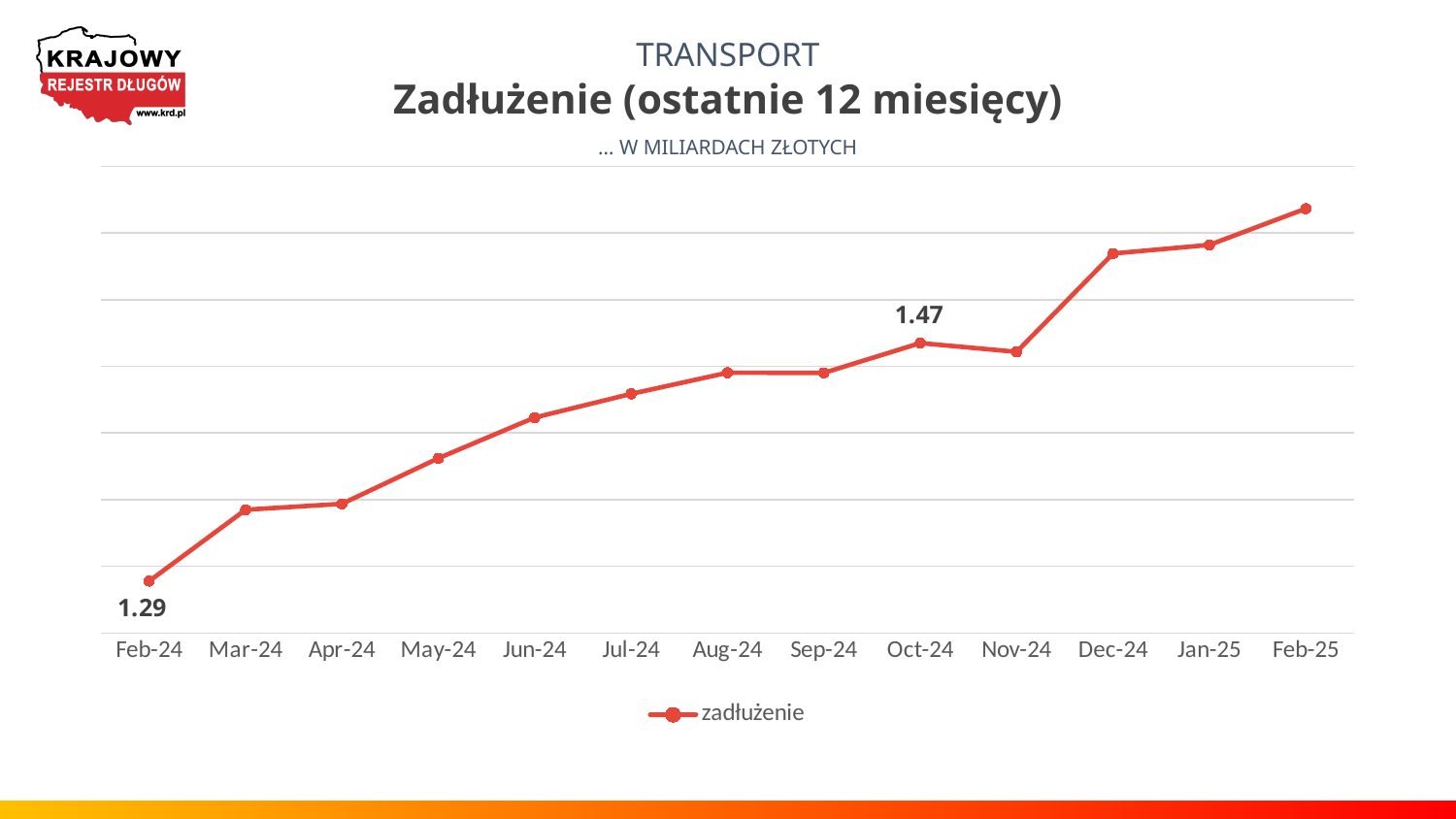
How many data points are plotted on the chart? 13 How many series does the legend list? 1 What is the name of the series shown in the legend? zadłużenie Which is larger, the value for Dec-24 or the value for Oct-24? Dec-24 Which is larger, the value for Jun-24 or the value for Mar-24? Jun-24 Do the values generally rise or fall from Feb-24 to Feb-25? rise What is the value for Oct-24? 1.47 Which month has the highest value? Feb-25 What kind of chart is shown on the slide? line chart What is the value for Feb-24? 1.29 What is the difference between the values for Oct-24 and Feb-24? 0.18 Which month has the lowest value? Feb-24